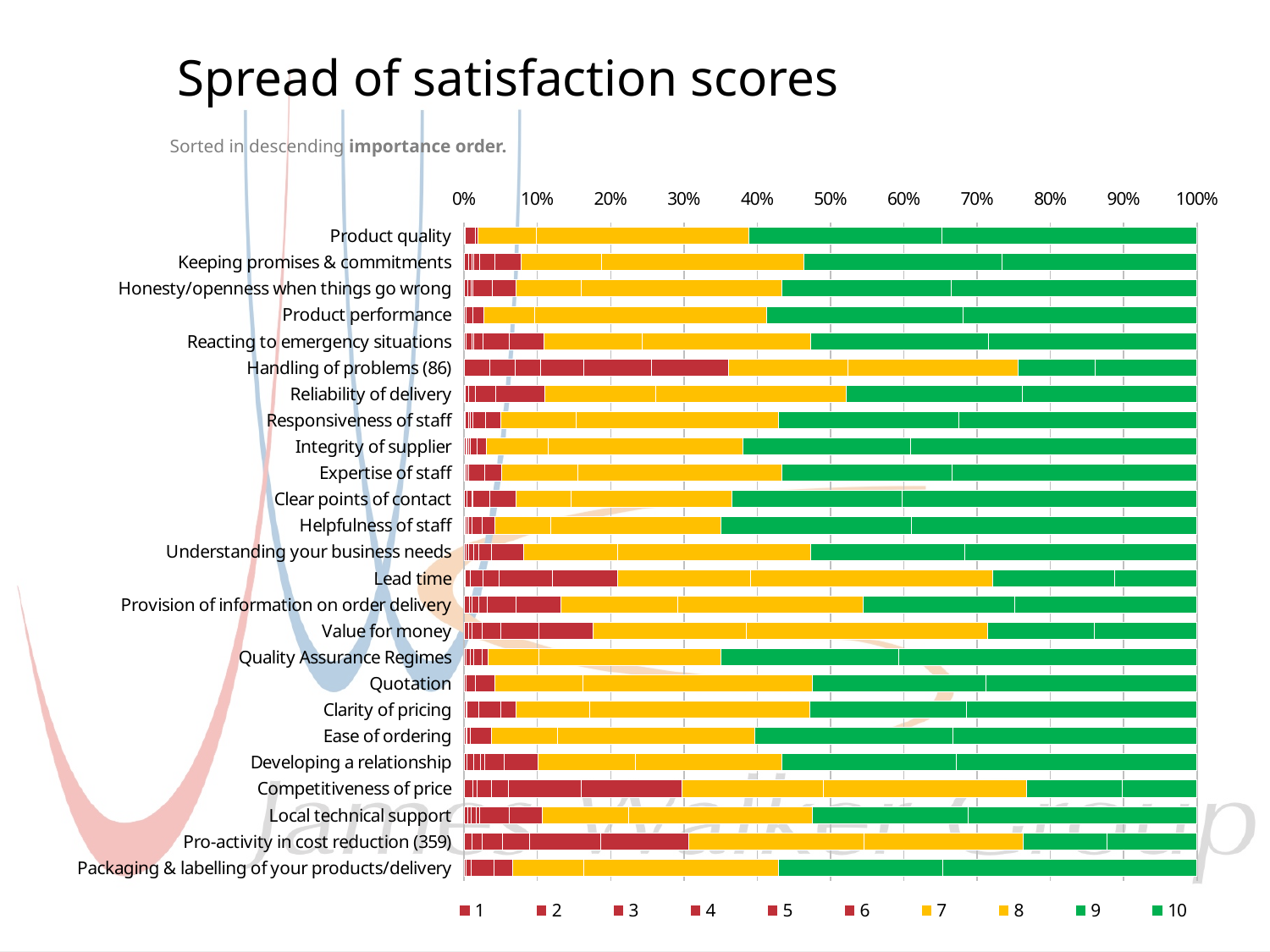
Is the combined share of scores 1 to 6 for Handling of problems (86) greater or less than 30%? greater Which has the larger combined share of scores 1 to 6, Handling of problems (86) or Product quality? Handling of problems (86) Is the combined share of scores 9 and 10 for Competitiveness of price greater or less than 30%? less How many categories (rows) are plotted in the chart? 25 Is the combined share of scores 9 and 10 for Product quality greater or less than 50%? greater What is the title of the chart? Spread of satisfaction scores Which category has the largest combined share of scores 1 to 6? Handling of problems (86) In what order are the categories sorted, according to the subtitle? Descending importance order What kind of chart is shown on the slide? Stacked bar chart How many series does the legend list? 10 Which has the larger combined share of scores 9 and 10, Product quality or Competitiveness of price? Product quality